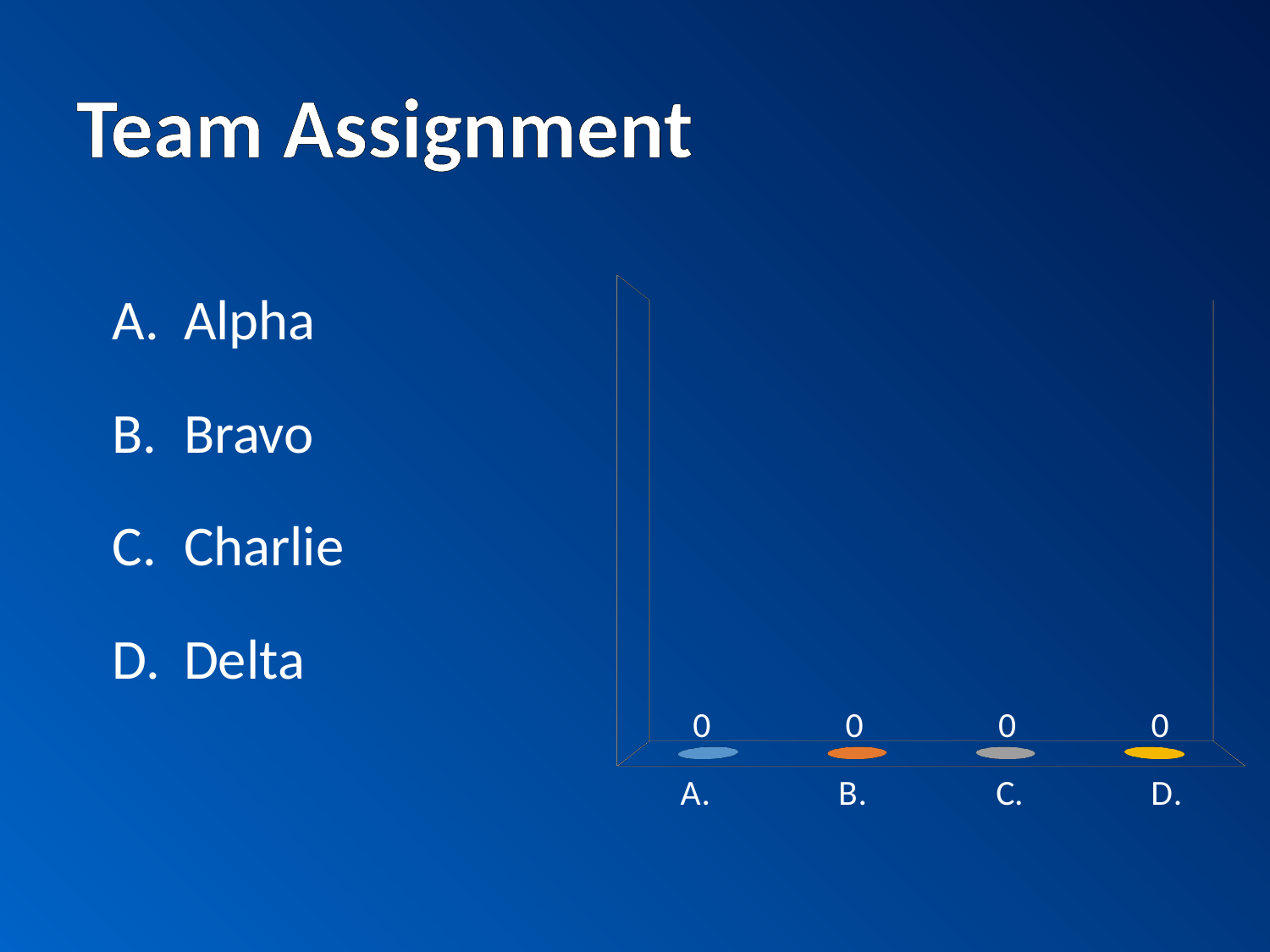
What is the title of the slide containing the chart? Team Assignment What is the value for category A. in the chart? 0 What is the difference between the values for A. and D.? 0 What colour is the bar for category B.? orange What is the total of the values for A., B., C. and D.? 0 What is the value for category B. in the chart? 0 How many categories are shown on the x axis of the chart? 4 What kind of chart is shown on the slide? bar chart What is the value for category C. in the chart? 0 What is the value for category D. in the chart? 0